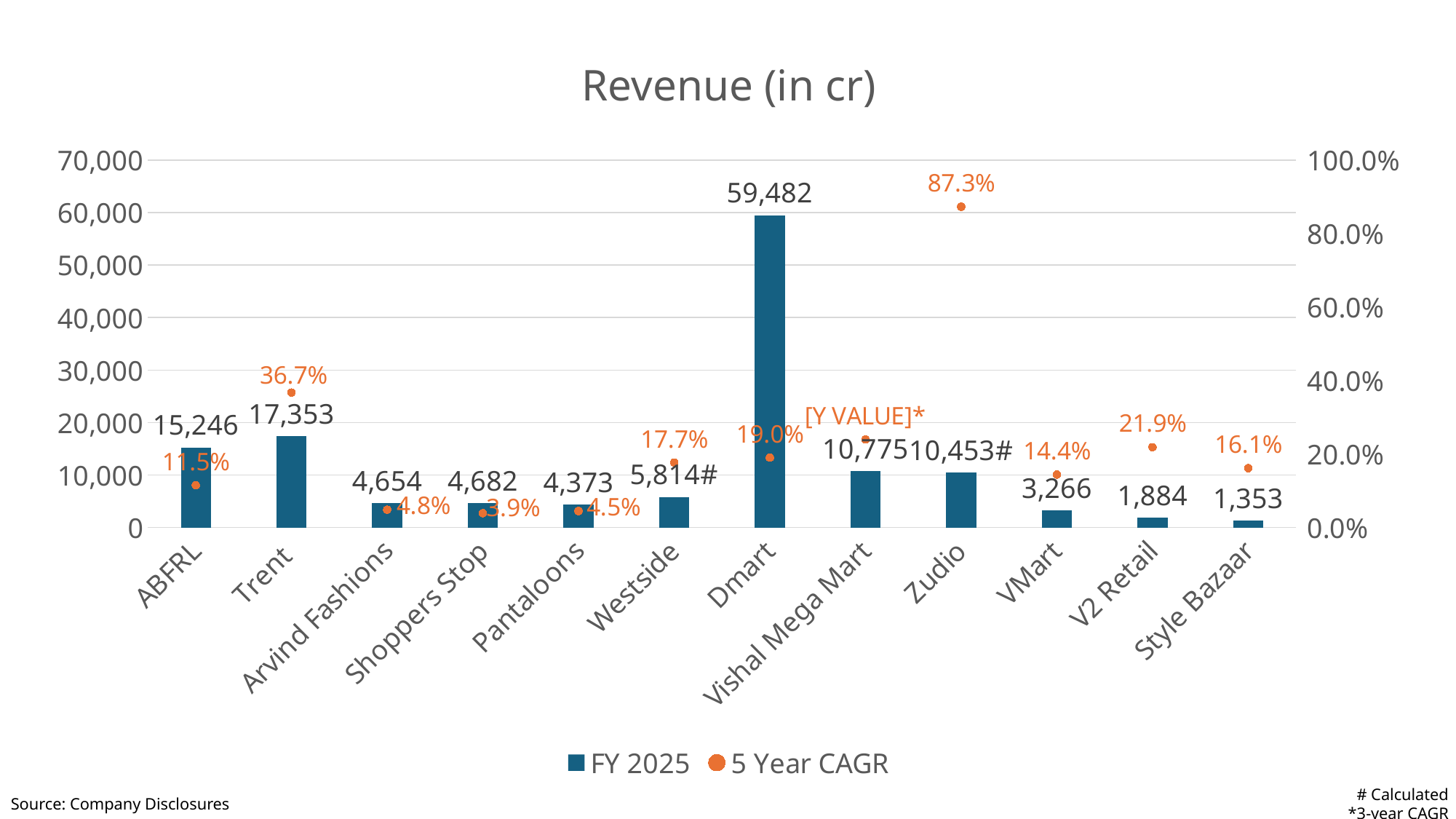
Which company has the lowest 5 Year CAGR shown? Shoppers Stop How many series does the legend list? 2 What kind of chart is this? Combination bar and dot chart Which company has the highest FY 2025 revenue? Dmart Which has the larger FY 2025 revenue, Vishal Mega Mart or Zudio? Vishal Mega Mart Which company has the lowest FY 2025 revenue? Style Bazaar What is the 5 Year CAGR shown for Zudio? 87.3% What is the difference in FY 2025 revenue between Trent and ABFRL? 2,107 What is the FY 2025 revenue for Dmart? 59,482 What is the 5 Year CAGR shown for V2 Retail? 21.9% How many companies are shown on the x axis? 12 What is the FY 2025 revenue for Trent? 17,353